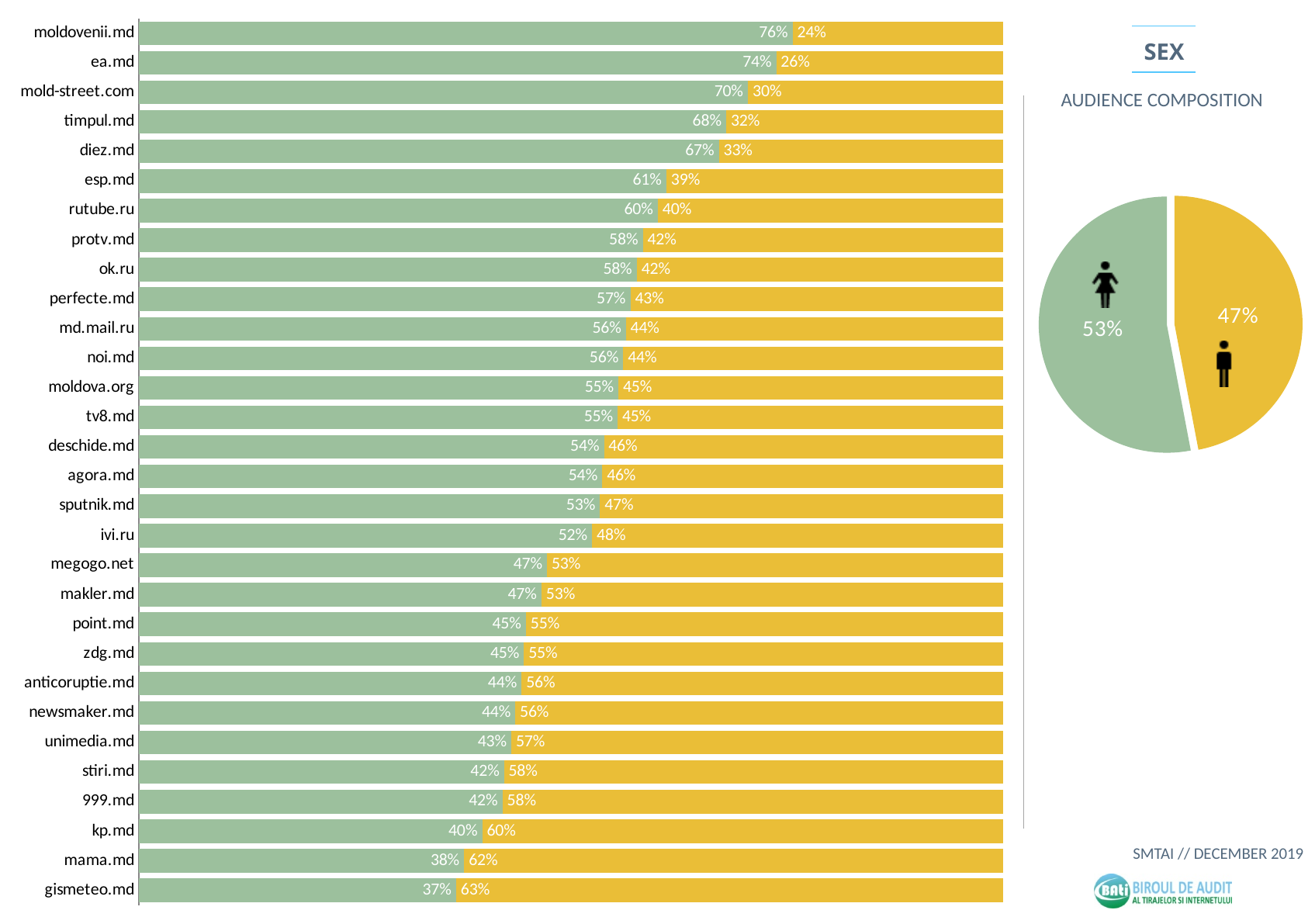
In the bar chart, what is the value of the green segment for sputnik.md? 53% What type of chart is the large chart on the left of the slide? Stacked bar chart In the pie chart, what share is shown for the green (female) slice? 53% In the bar chart, what is the difference between the green segment values of ea.md and mama.md? 36% In the bar chart, which website has the lowest green (female) share? gismeteo.md What is the title shown above the pie chart? SEX In the bar chart, what is the total of the two segments for timpul.md? 100% In the bar chart, which website has the highest green (female) share? moldovenii.md How many websites are listed in the bar chart? 30 In the bar chart, what is the value of the green (female) segment for moldovenii.md? 76% In the bar chart, which has a larger yellow (male) segment, kp.md or rutube.ru? kp.md In the bar chart, what is the value of the yellow (male) segment for gismeteo.md? 63%